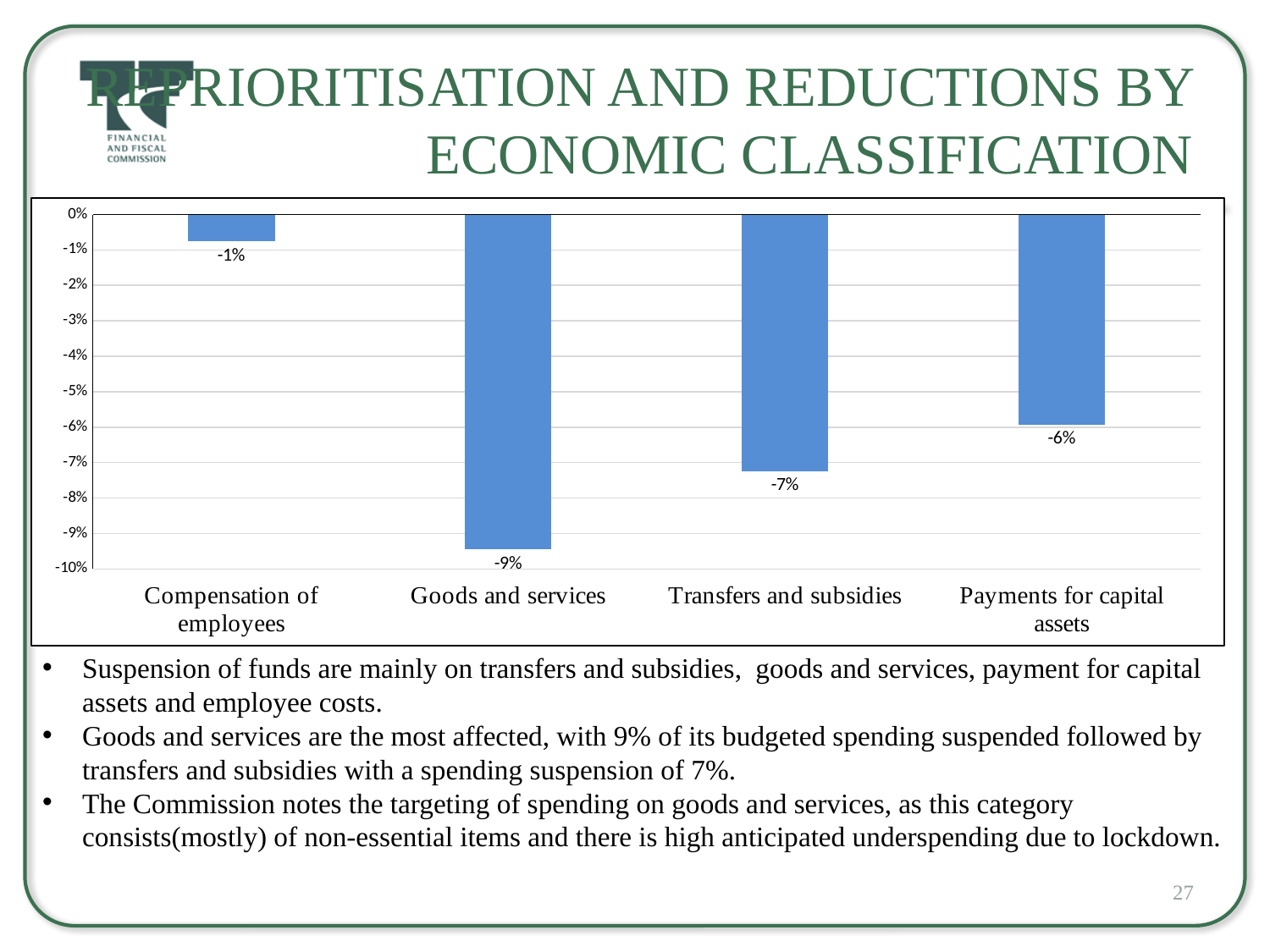
What is the value shown for Goods and services? -9% Is the value for Payments for capital assets greater or less than -5%? less How many categories are plotted on the chart? 4 What is the difference in percentage points between the values for Goods and services and Transfers and subsidies? 2 percentage points What kind of chart is shown on the slide? Bar chart What is the value shown for Payments for capital assets? -6% Which shows a larger reduction: Transfers and subsidies or Payments for capital assets? Transfers and subsidies Which category has the highest value, i.e. the smallest reduction? Compensation of employees What is the value shown for Compensation of employees? -1% What is the lowest value shown on the vertical axis? -10% What is the value shown for Transfers and subsidies? -7% Which category has the lowest (most negative) value? Goods and services